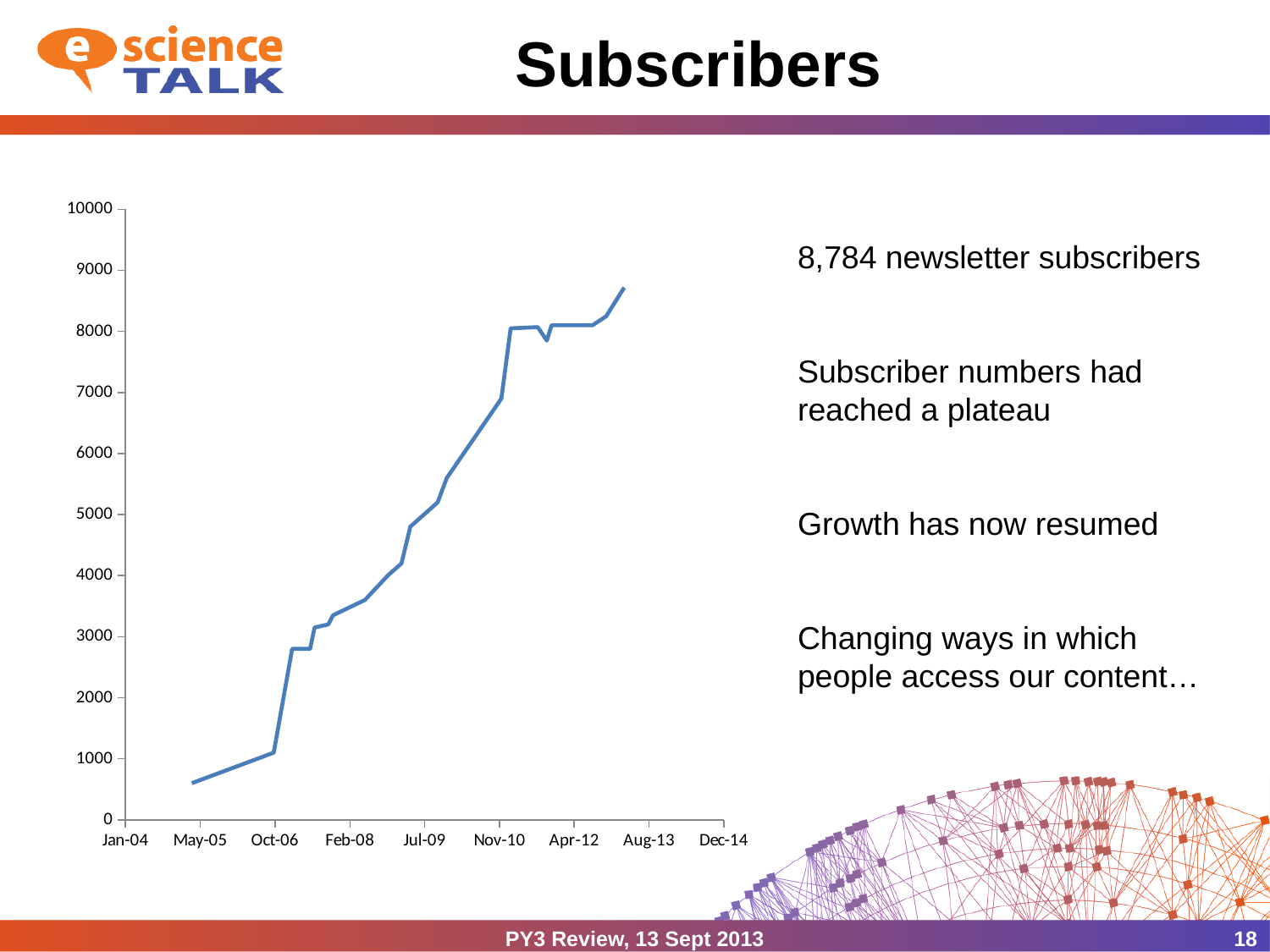
Do the values on the chart generally rise or fall from left to right along the x axis? rise What is the first label on the x axis? Jan-04 Is the final value of the line (near Aug-13) greater or less than 8000? greater Is the value of the line at Feb-08 greater or less than 5000? less What kind of chart is shown on the slide? line chart Is the value of the line at May-05 greater or less than 1000? less Which is larger, the value of the line at Jul-09 or at Nov-10? Nov-10 What is the highest value shown on the y axis? 10000 Which is larger, the value of the line at Oct-06 or at Feb-08? Feb-08